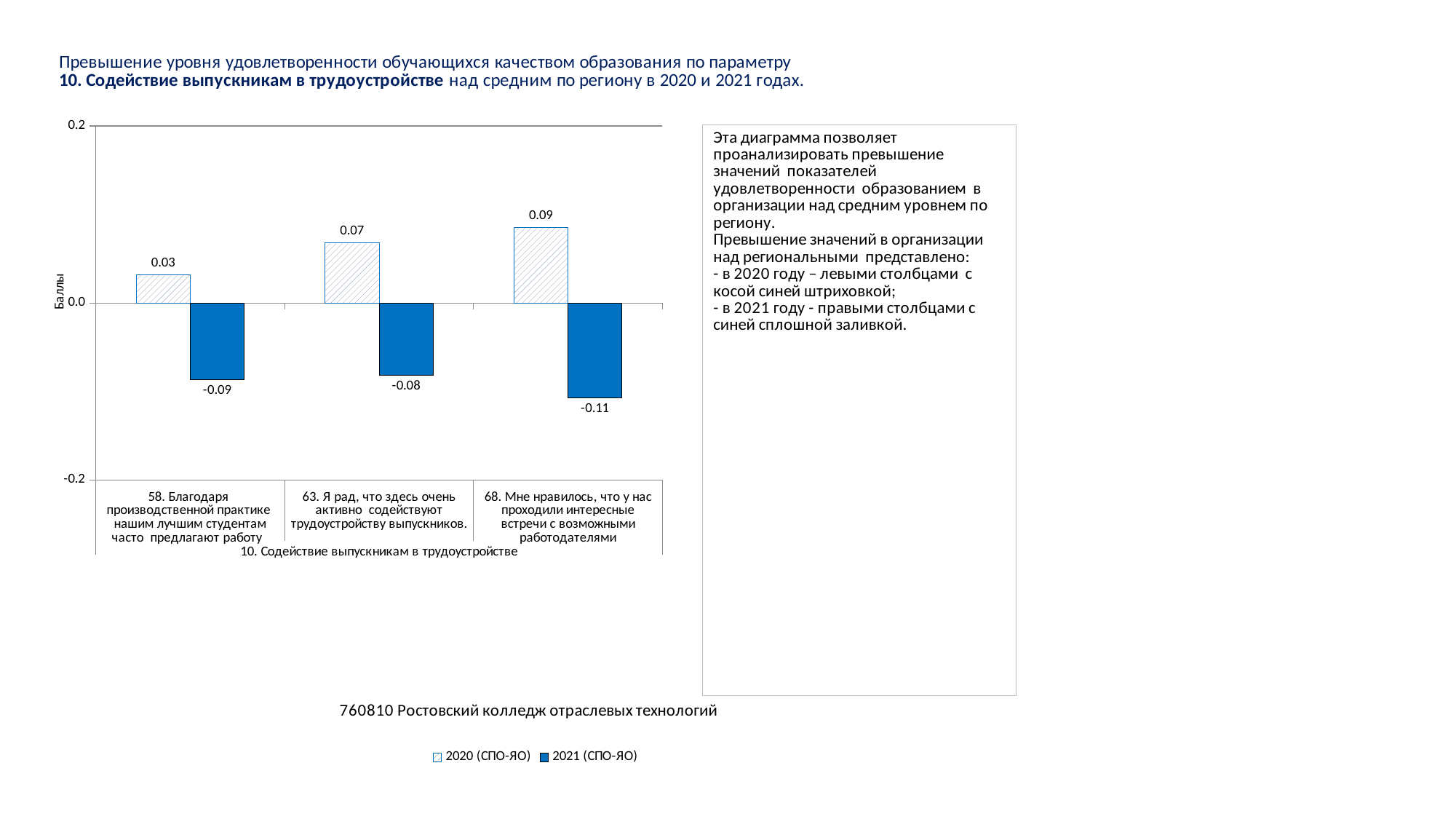
What is the difference between the 2020 and 2021 values for category 63? 0.15 Which is larger: the 2020 value for category 58 or the 2020 value for category 63? 2020 value for category 63 What is the 2021 (СПО-ЯО) value for category 63 (Я рад, что здесь очень активно содействуют трудоустройству выпускников)? -0.08 How many series does the legend list? 2 What kind of chart is shown on the slide? Bar chart What is the 2020 (СПО-ЯО) value for category 58 (Благодаря производственной практике нашим лучшим студентам часто предлагают работу)? 0.03 How many categories are shown on the x axis? 3 What is the 2021 (СПО-ЯО) value for category 68 (Мне нравилось, что у нас проходили интересные встречи с возможными работодателями)? -0.11 What is the label of the vertical axis? Баллы Do the 2020 (СПО-ЯО) values rise or fall from left to right across the categories? Rise Which category has the lowest 2021 (СПО-ЯО) value? 68. Мне нравилось, что у нас проходили интересные встречи с возможными работодателями Which category has the highest 2020 (СПО-ЯО) value? 68. Мне нравилось, что у нас проходили интересные встречи с возможными работодателями